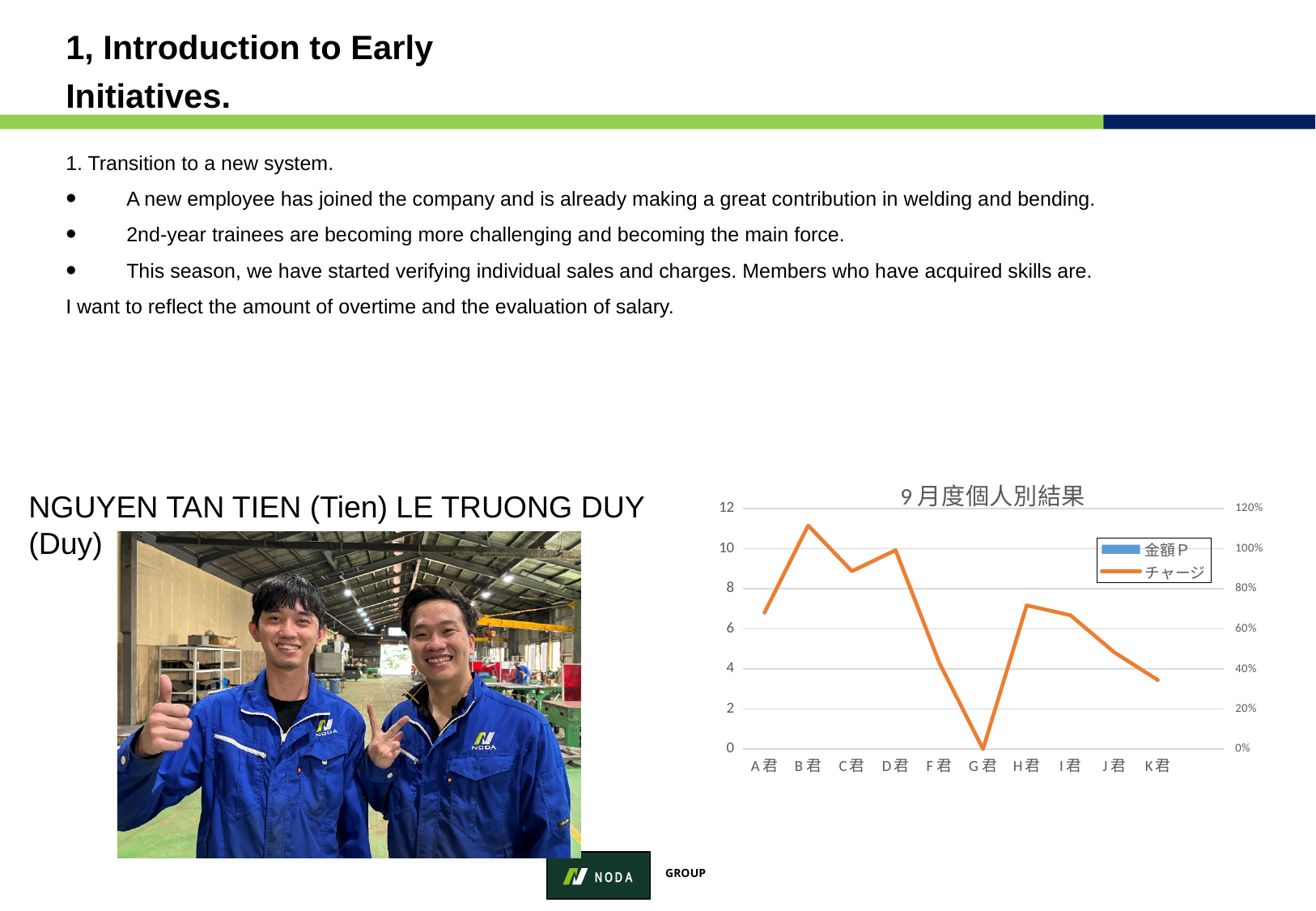
Does the チャージ line rise or fall from D君 to G君? fall How many series does the chart legend list? 2 What is the title of the chart? 9月度個人別結果 Which category has the highest value on the チャージ line? B君 Is the チャージ value for B君 greater or less than 10 on the left axis? greater What are the two series named in the chart legend? 金額P and チャージ Is the チャージ value for H君 greater or less than 6 on the left axis? greater Which has the larger チャージ value, D君 or J君? D君 Is the チャージ value for K君 greater or less than 4 on the left axis? less How many categories are shown on the x axis of the chart? 10 Which category has the lowest value on the チャージ line? G君 Which has the larger チャージ value, B君 or C君? B君